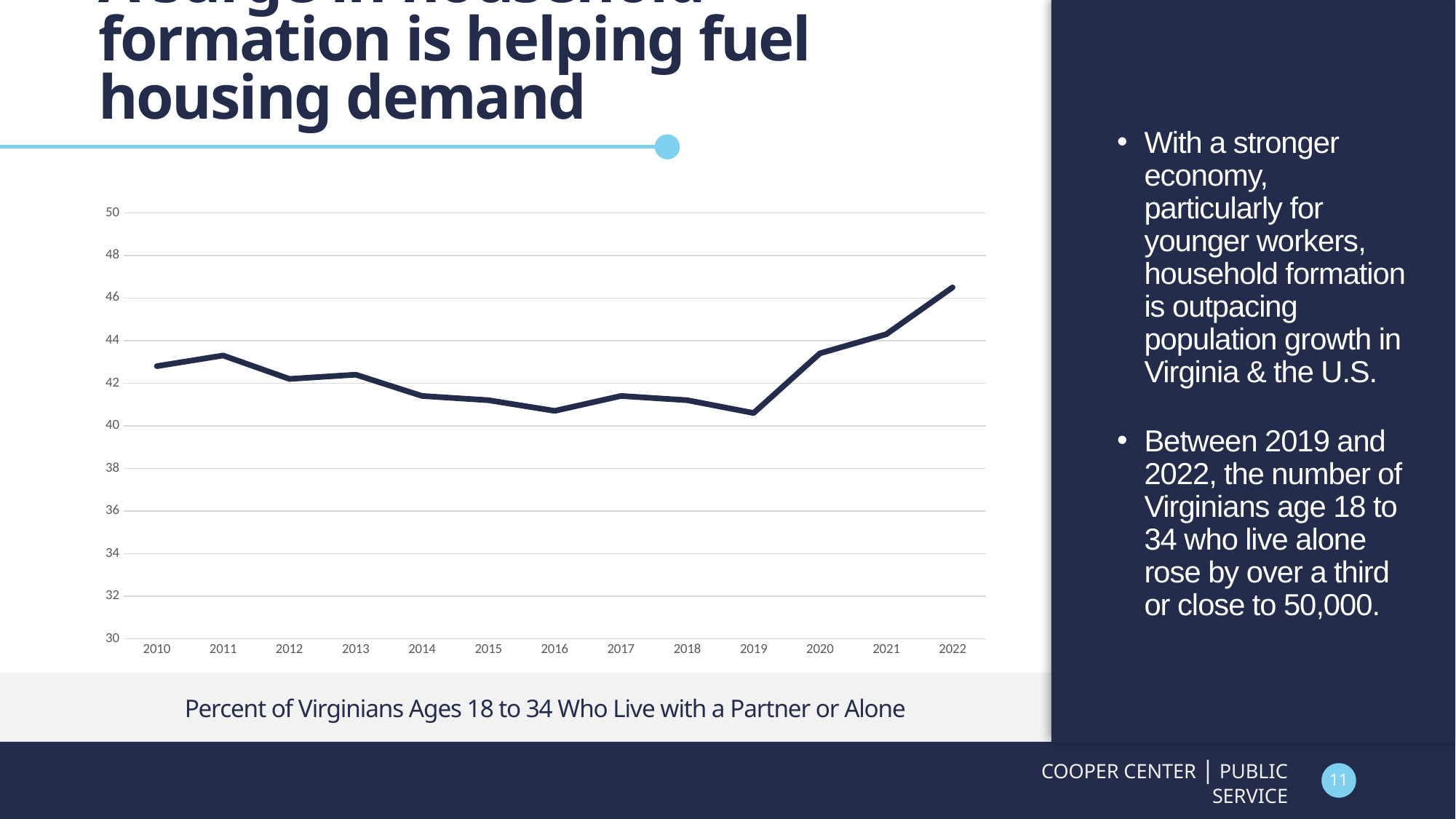
What caption describes the data shown in the chart? Percent of Virginians Ages 18 to 34 Who Live with a Partner or Alone Is the value for 2020 greater or less than 44? less Which year has the highest value on the chart? 2022 Is the value for 2010 greater or less than 42? greater Do the values rise or fall between 2019 and 2022? rise Is the value for 2019 greater or less than 42? less Which is larger, the value for 2022 or the value for 2010? 2022 Which is larger, the value for 2011 or the value for 2019? 2011 How many years are plotted along the x axis of the chart? 13 Do the values rise or fall between 2011 and 2016? fall What kind of chart is shown on the slide? line chart